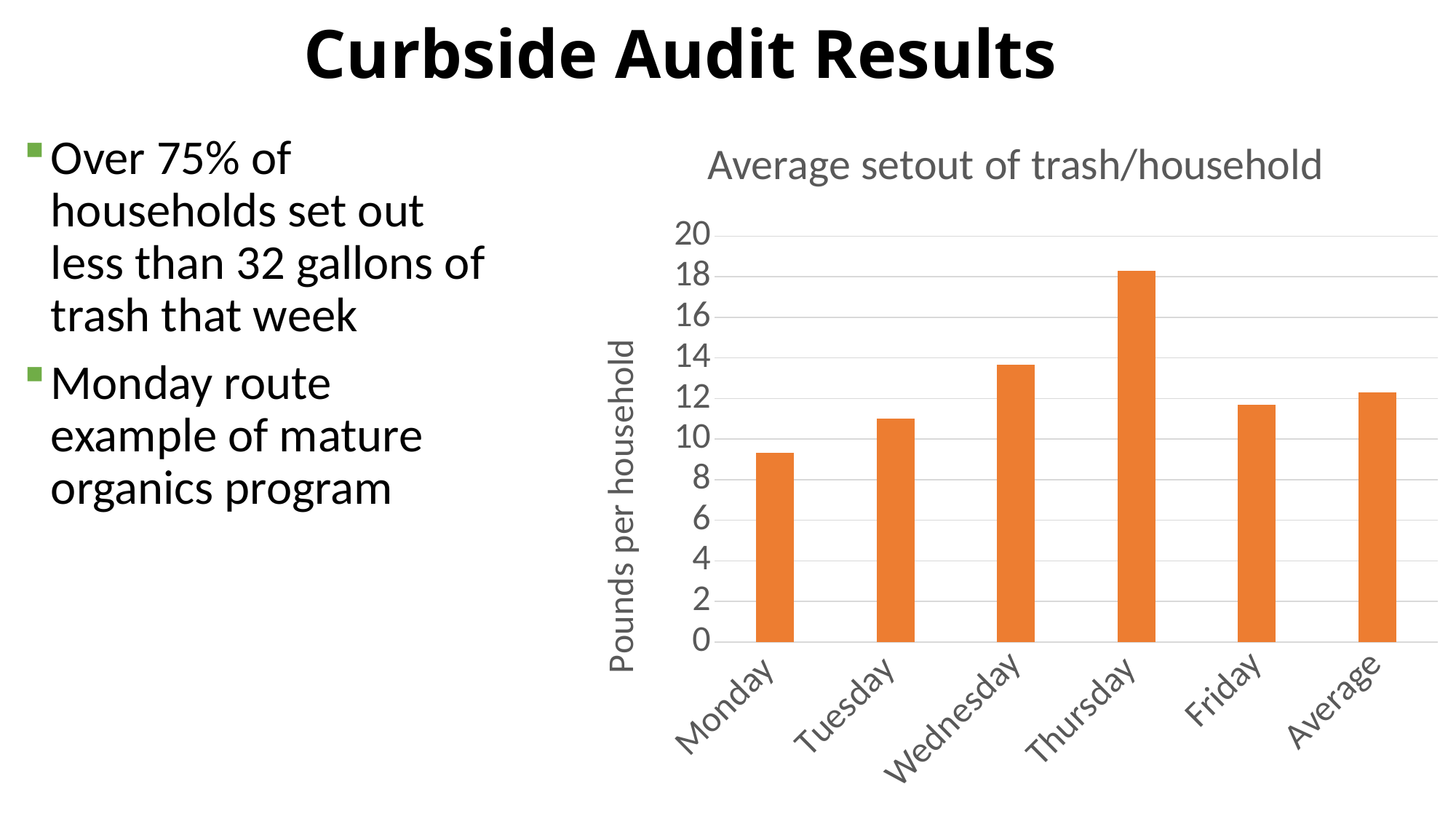
How many bars are plotted in the chart? 6 Which category has the highest value in the chart? Thursday Which is larger, the value for Monday or the value for Tuesday? Tuesday Which category has the lowest value in the chart? Monday Is the value for Wednesday greater or less than 12? greater What is the title of the chart? Average setout of trash/household What type of chart is shown on the slide? bar chart Is the value for Monday greater or less than 10? less Is the value for Thursday greater or less than 16? greater What is the label on the vertical axis of the chart? Pounds per household Which is larger, the value for Wednesday or the value for Friday? Wednesday